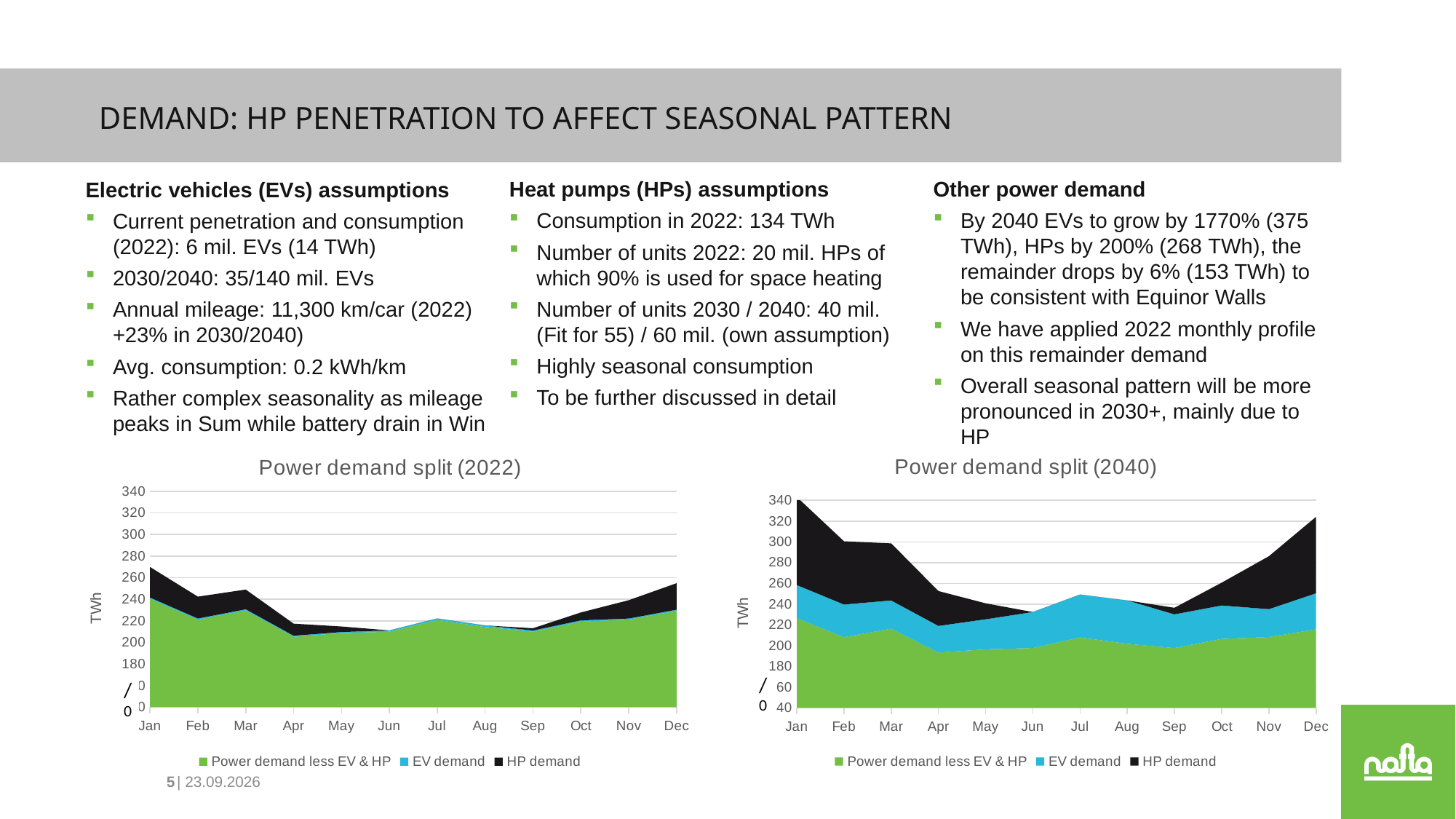
What unit is shown on the y axis of the 'Power demand split (2022)' chart? TWh In the 'Power demand split (2040)' chart, is the total power demand in Sep greater or less than 260 TWh? less Which series is shown in black in the 'Power demand split (2040)' chart? HP demand How many series does the legend of the 'Power demand split (2040)' chart list? 3 In the 'Power demand split (2022)' chart, is the total power demand in Jun greater or less than 220 TWh? less In the 'Power demand split (2040)' chart, does the total power demand rise or fall from Sep to Dec? rise How many months are plotted along the x axis of the 'Power demand split (2022)' chart? 12 What kind of chart is the 'Power demand split (2022)' chart? Stacked area chart In the 'Power demand split (2022)' chart, is the total power demand in Jan greater or less than 260 TWh? greater In the 'Power demand split (2040)' chart, which month has the higher total power demand, Jan or Jul? Jan In the 'Power demand split (2022)' chart, which month has the higher total power demand, Jan or Sep? Jan